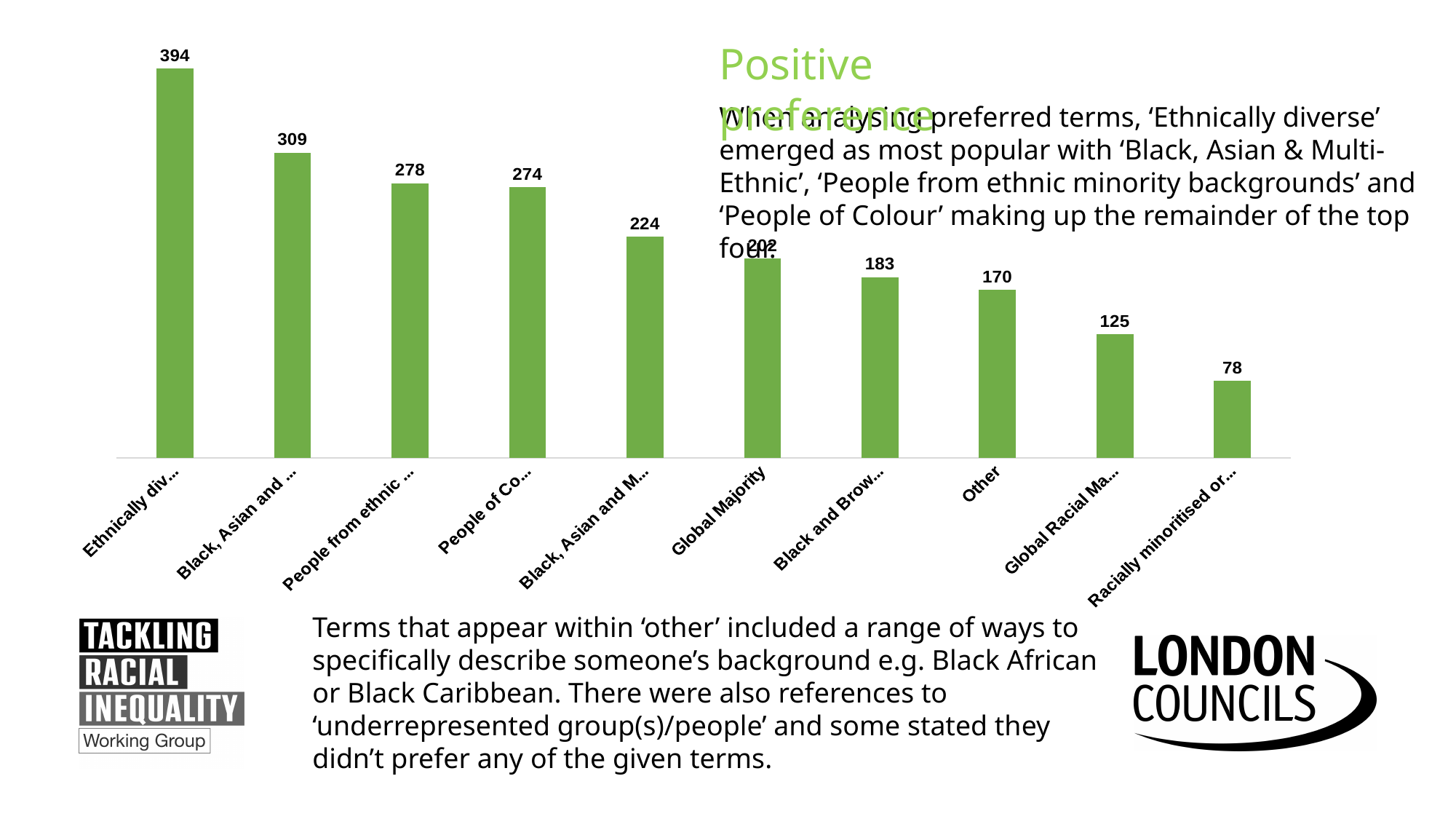
What is the lowest value shown on the chart? 78 What is the highest value shown on the chart? 394 What kind of chart is shown on the slide? Bar chart What colour are the bars in the chart? Green What is the value shown for the leftmost bar in the chart? 394 What is the value shown for the 'Other' category? 170 What is the difference between the values of the first and second bars from the left? 85 How many bars are shown in the chart? 10 Do the values rise or fall moving from left to right across the chart? Fall What is the value shown for the rightmost bar in the chart? 78 What is the difference between the value for 'Other' and the value of the rightmost bar? 92 Which has a larger value, 'Global Majority' or 'Other'? Global Majority